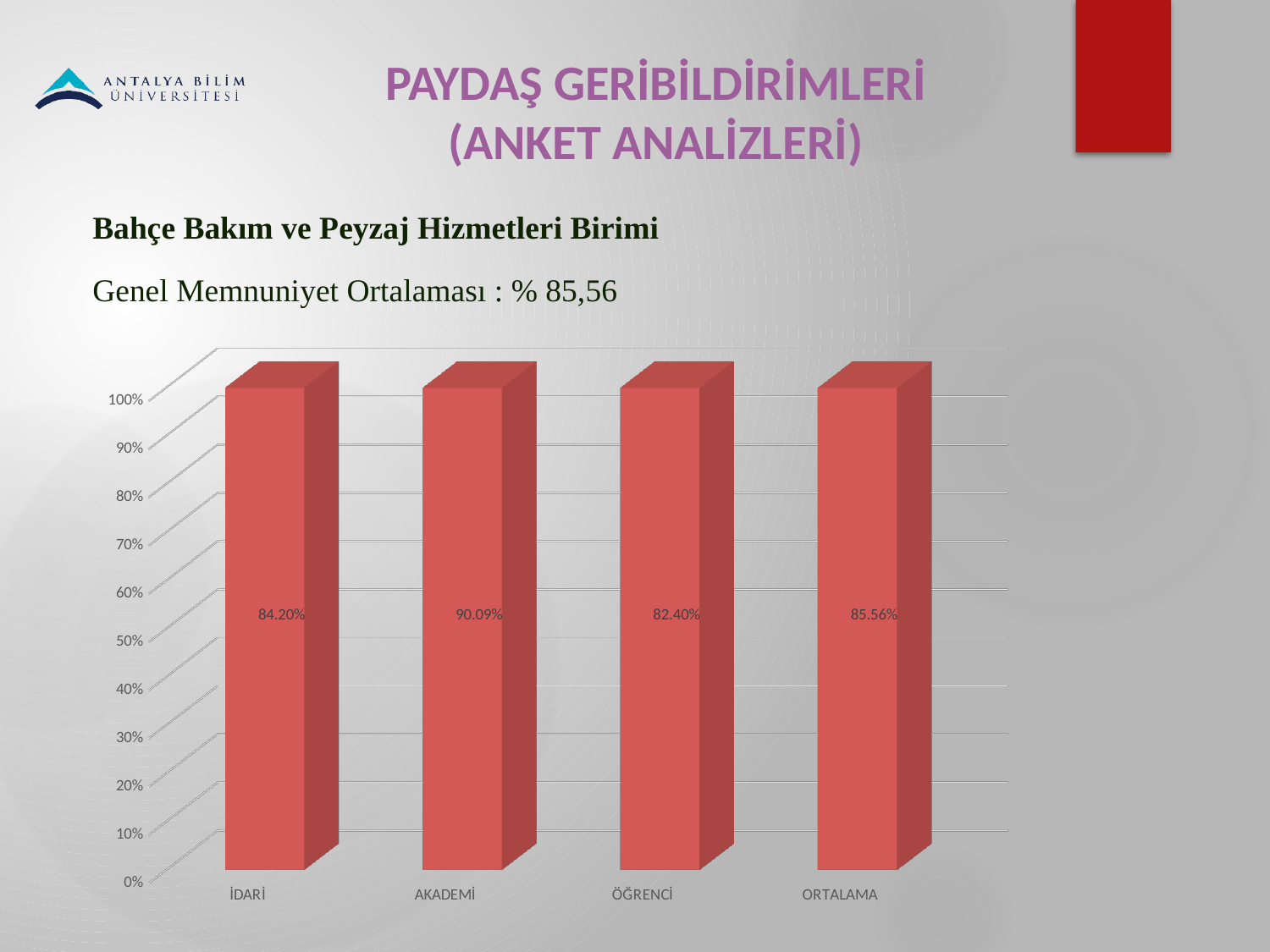
What is the value for ÖĞRENCİ? 82.40% Which category has the highest value? AKADEMİ How many categories are shown on the x axis? 4 What is the value for AKADEMİ? 90.09% What is the difference between the values for AKADEMİ and İDARİ? 5.89 percentage points Which is larger, the value for İDARİ or the value for ÖĞRENCİ? İDARİ What is the value for İDARİ? 84.20% What is the value for ORTALAMA? 85.56% What is the difference between the values for ORTALAMA and ÖĞRENCİ? 3.16 percentage points What kind of chart is shown on the slide? Bar chart What colour are the bars in the chart? Red Which category has the lowest value? ÖĞRENCİ